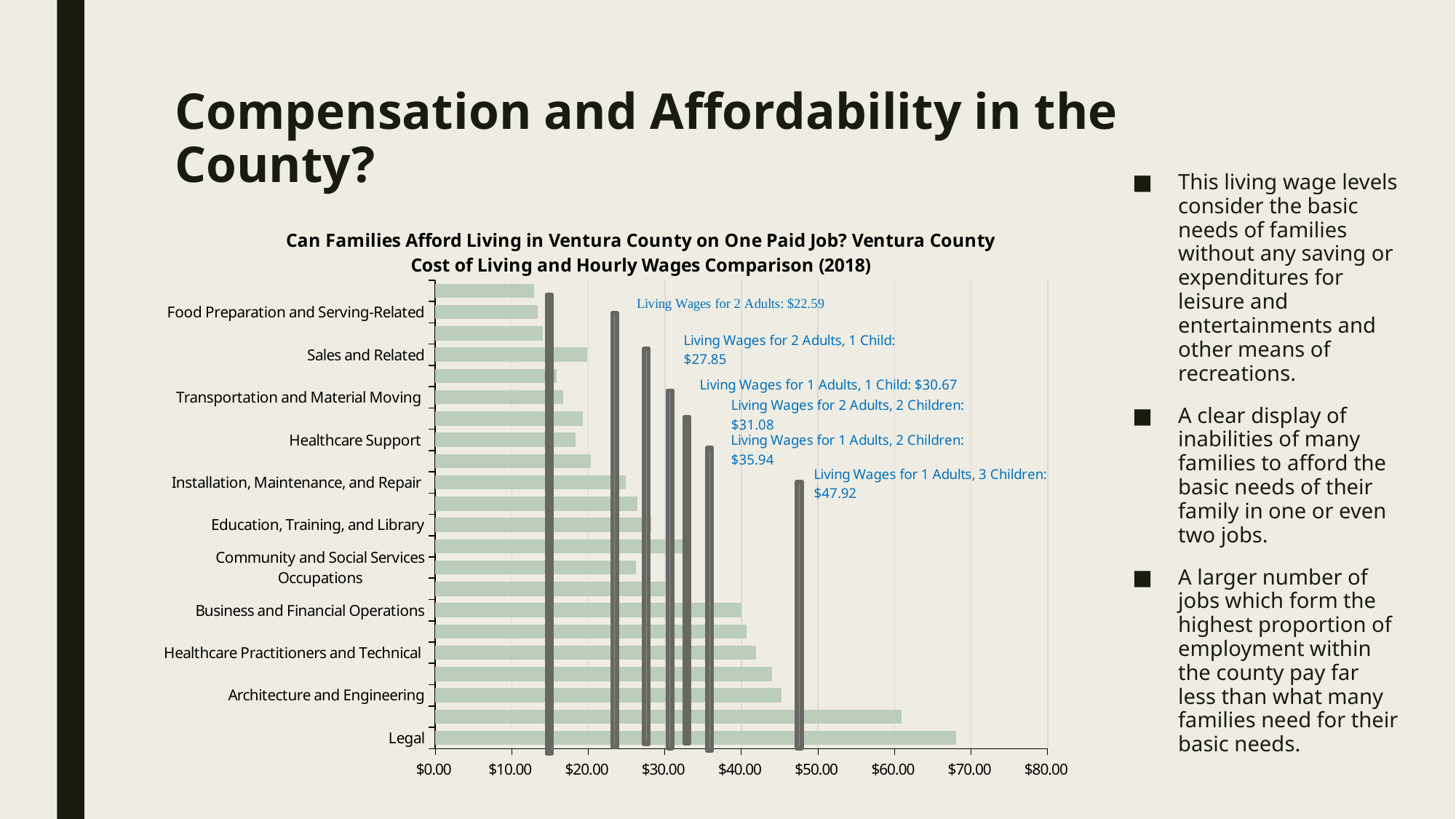
Is the hourly wage bar for Food Preparation and Serving-Related greater or less than $20.00? less Which occupation category has the highest hourly wage bar? Legal What is the difference between the living wage for 1 Adult, 3 Children and the living wage for 2 Adults? $25.33 What is the living wage shown for 2 Adults? $22.59 Is the hourly wage bar for Legal greater or less than $60.00? greater Which has the larger hourly wage bar, Legal or Sales and Related? Legal What kind of chart is shown on the slide? Bar chart Is the hourly wage bar for Architecture and Engineering greater or less than $40.00? greater What is the maximum value shown on the horizontal axis? $80.00 What is the living wage shown for 1 Adult with 3 Children? $47.92